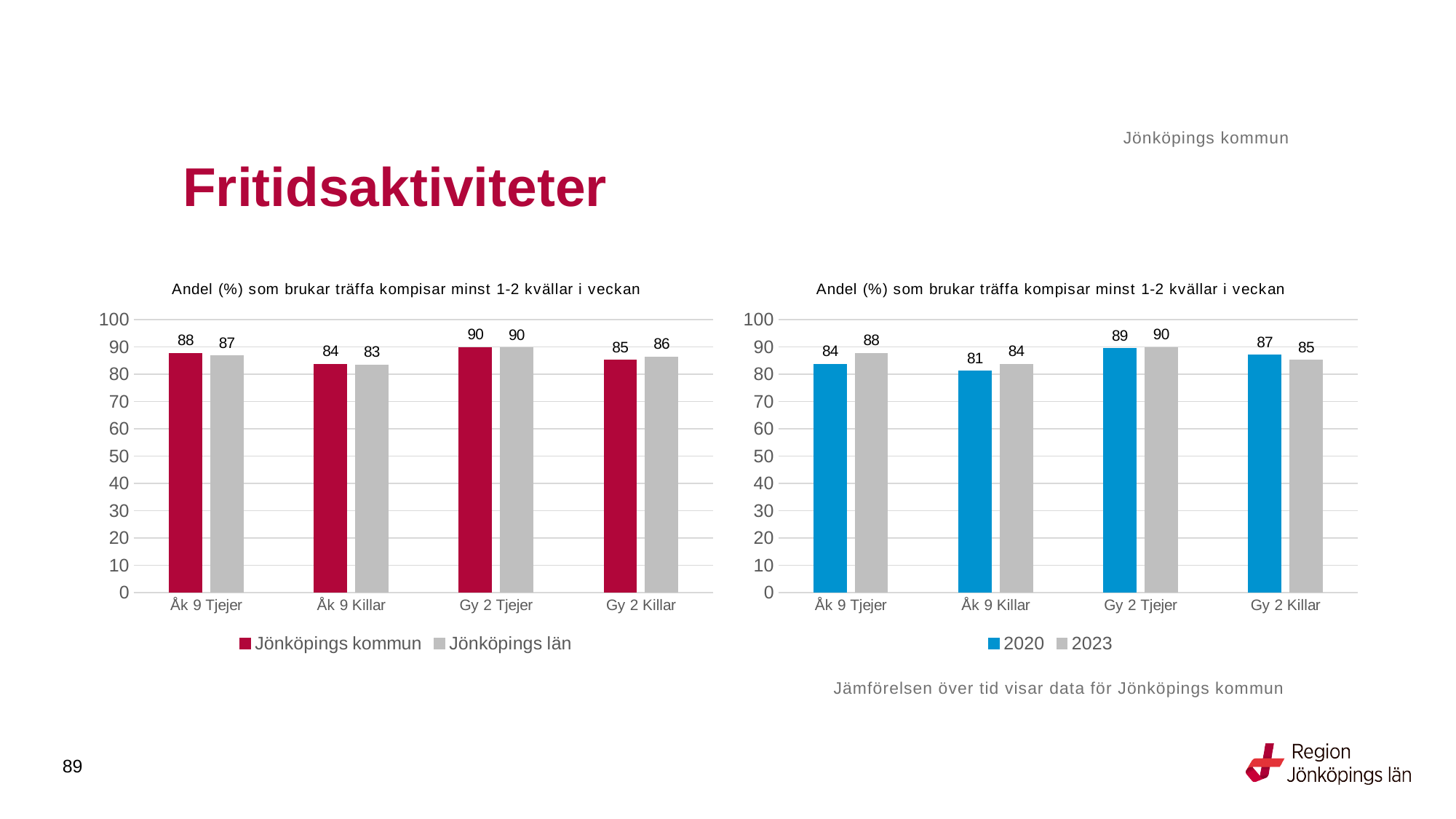
What are the two legend entries of the left chart? Jönköpings kommun and Jönköpings län In the right chart, which category has the highest 2020 value? Gy 2 Tjejer In the right chart, what is the 2023 value for Gy 2 Tjejer? 90 How many series does the legend of the right chart list? 2 In the right chart, what is the difference between the 2023 and 2020 values for Åk 9 Tjejer? 4 In the right chart, what is the 2020 value for Åk 9 Killar? 81 In the left chart, which category has the lowest value for Jönköpings kommun? Åk 9 Killar In the right chart, for Gy 2 Killar, which is larger: the 2020 value or the 2023 value? 2020 In the left chart, what is the value for Jönköpings kommun for Åk 9 Tjejer? 88 In the left chart, what is the value for Jönköpings län for Gy 2 Killar? 86 How many categories are shown on the x axis of the left chart? 4 What kind of chart is the left chart? Bar chart